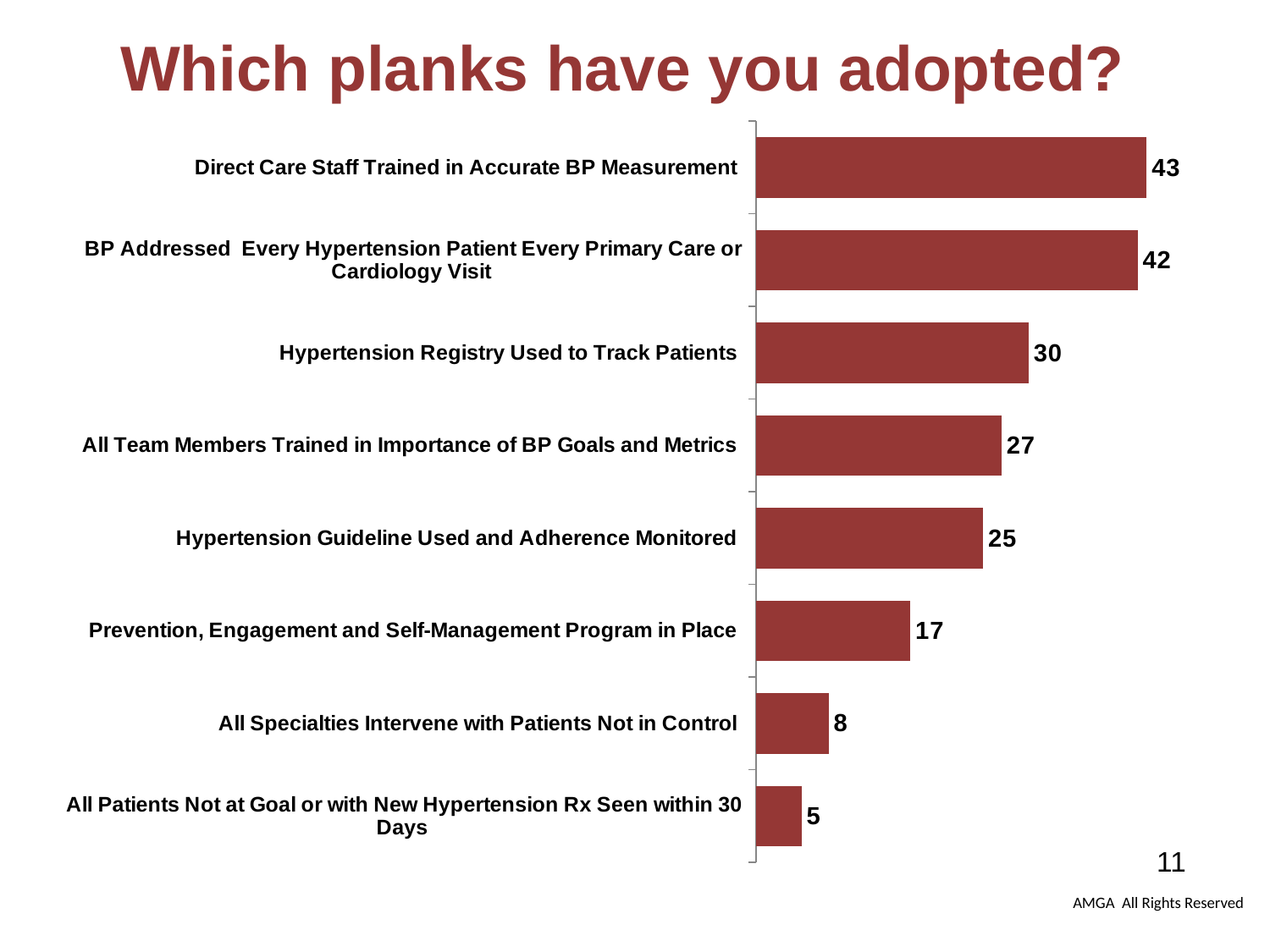
What is the value for "Hypertension Registry Used to Track Patients"? 30 How many categories are shown in the chart? 8 What is the difference between the values for "All Team Members Trained in Importance of BP Goals and Metrics" and "Hypertension Guideline Used and Adherence Monitored"? 2 Which is larger: the value for "Hypertension Guideline Used and Adherence Monitored" or the value for "Prevention, Engagement and Self-Management Program in Place"? Hypertension Guideline Used and Adherence Monitored What is the title of the chart? Which planks have you adopted? What colour are the bars in the chart? Dark red What is the value for "All Specialties Intervene with Patients Not in Control"? 8 What kind of chart is shown on the slide? Bar chart Which category has the lowest value? All Patients Not at Goal or with New Hypertension Rx Seen within 30 Days What is the value for "Prevention, Engagement and Self-Management Program in Place"? 17 What is the difference between the values for "Direct Care Staff Trained in Accurate BP Measurement" and "Hypertension Registry Used to Track Patients"? 13 Which category has the highest value? Direct Care Staff Trained in Accurate BP Measurement